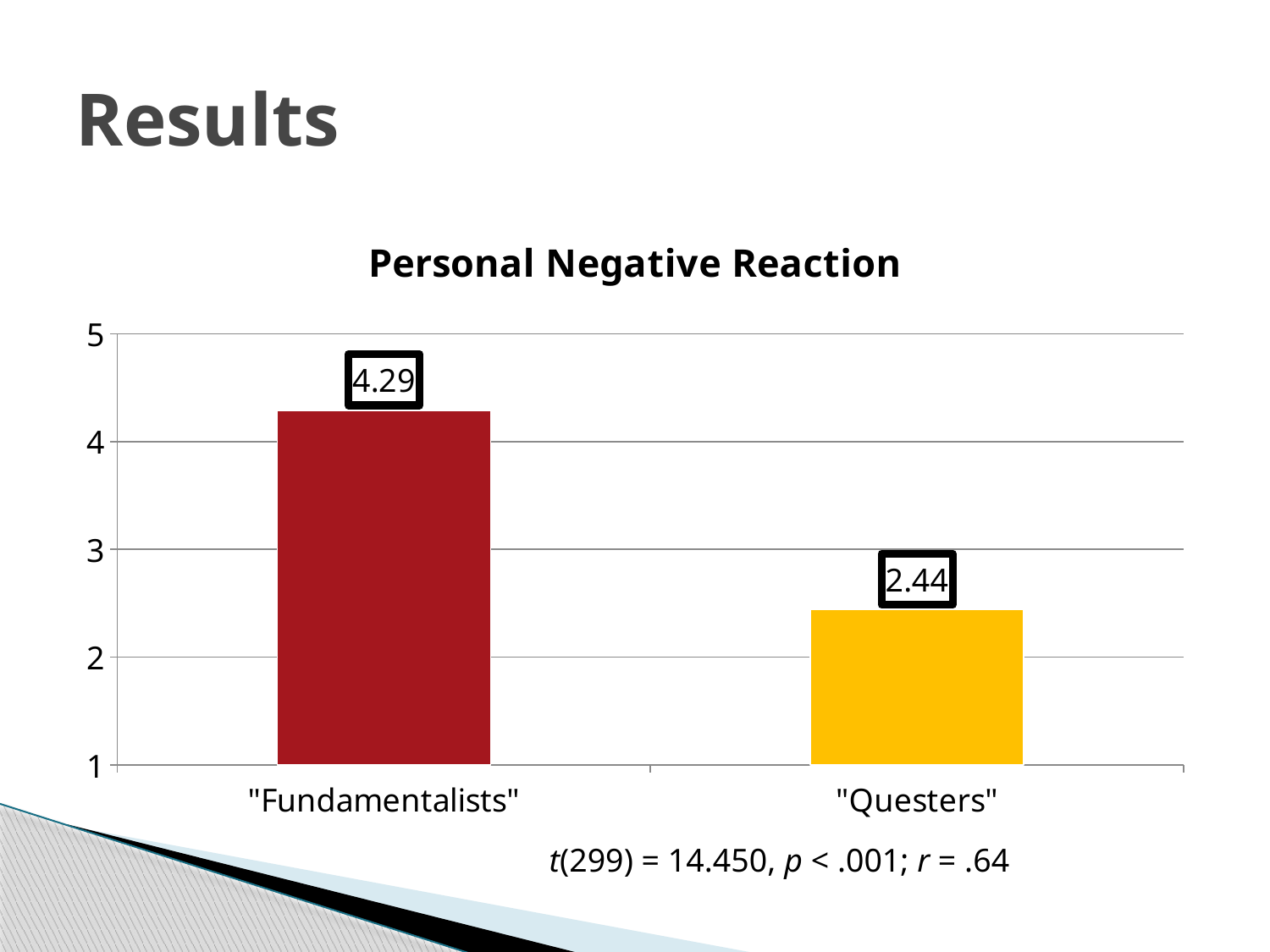
What is the value for "Fundamentalists"? 4.29 What kind of chart is shown on the slide? bar chart What is the difference between the values for "Fundamentalists" and "Questers"? 1.85 What is the title of the chart? Personal Negative Reaction Is the value for "Fundamentalists" greater or less than 4? greater How many categories are shown on the chart? 2 What colour is the bar for "Questers"? yellow What is the value for "Questers"? 2.44 Which is larger, the value for "Fundamentalists" or the value for "Questers"? "Fundamentalists" Which category has the highest value? "Fundamentalists" Which category has the lowest value? "Questers" Is the value for "Questers" greater or less than 3? less